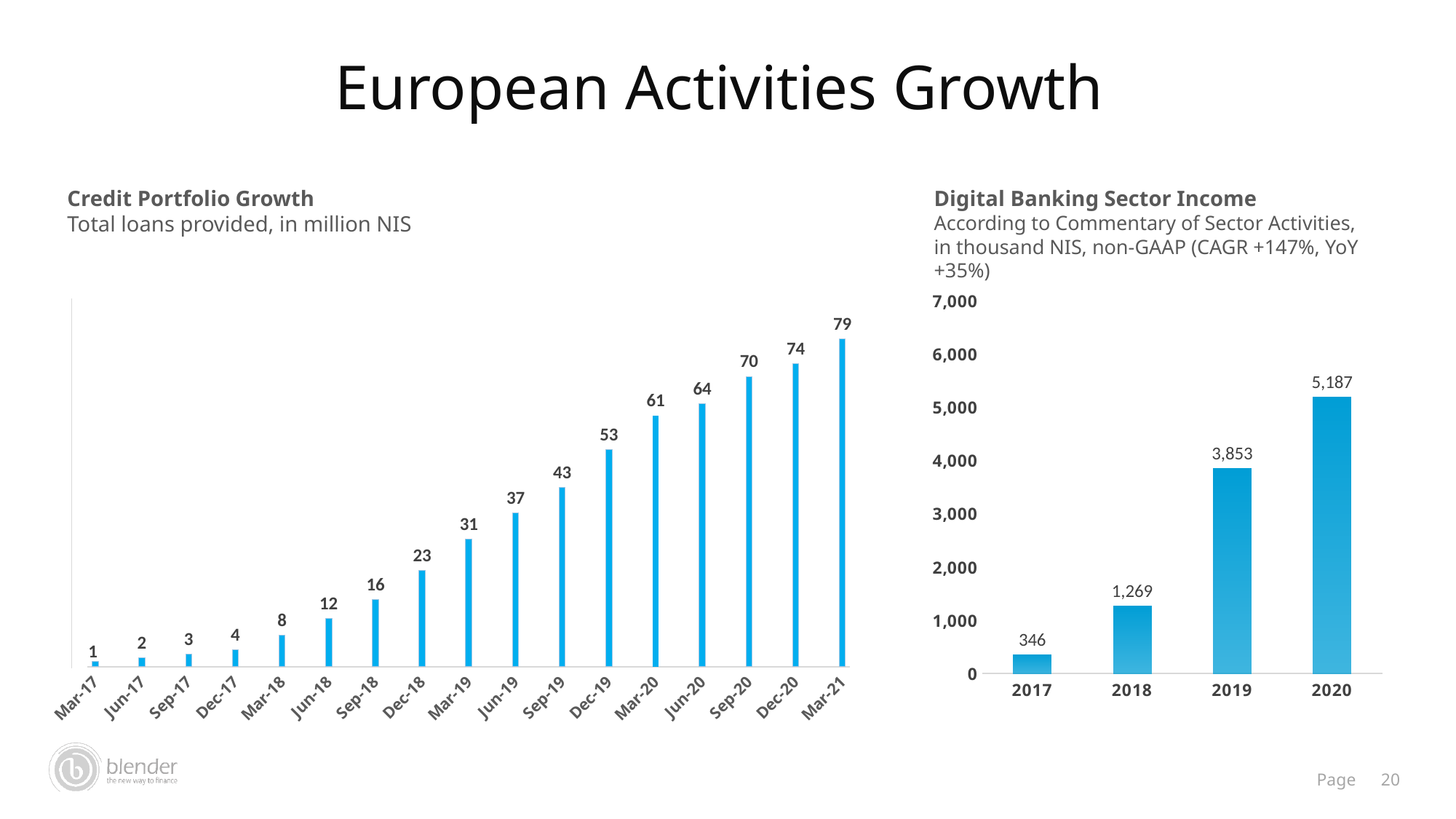
What kind of chart is the Digital Banking Sector Income chart? bar chart In the Digital Banking Sector Income chart, what is the difference between 2020 and 2019? 1,334 In the Credit Portfolio Growth chart, how many periods are shown on the x axis? 17 In the Credit Portfolio Growth chart, which period has the lowest value? Mar-17 In the Credit Portfolio Growth chart, do the values rise or fall from Mar-17 to Mar-21? rise In the Credit Portfolio Growth chart, what is the difference between Mar-20 and Mar-19? 30 In the Digital Banking Sector Income chart, how many years are shown? 4 In the Digital Banking Sector Income chart, is the value for 2018 greater or less than 1,000? greater In the Credit Portfolio Growth chart, what is the value for Mar-21? 79 In the Digital Banking Sector Income chart, which year has the highest value? 2020 In the Digital Banking Sector Income chart, what is the value for 2019? 3,853 In the Credit Portfolio Growth chart, what is the value for Dec-18? 23